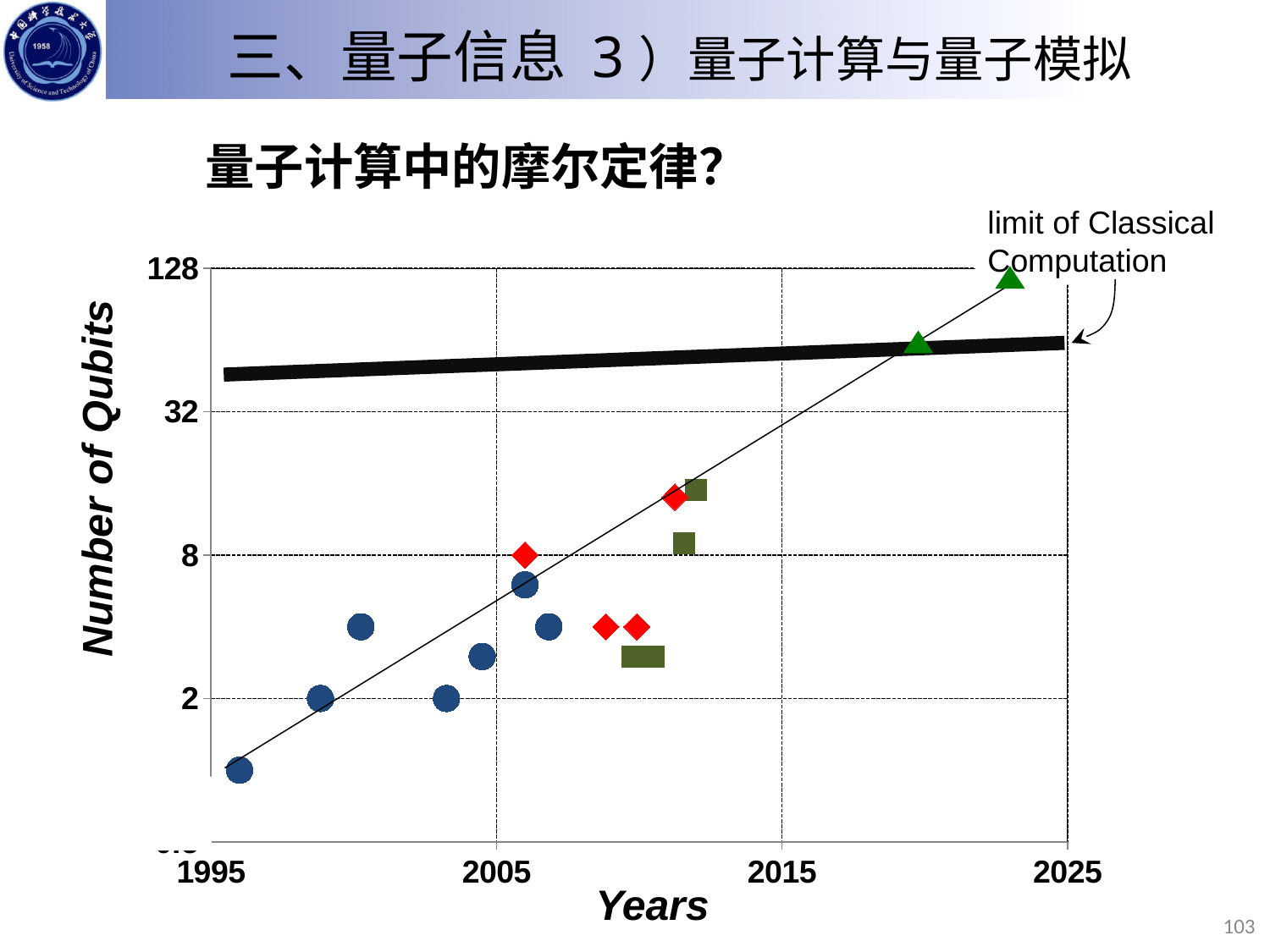
What does the thick black line on the chart represent, according to its label? limit of Classical Computation Which is higher: the green triangle near 2020 or the green triangle near 2023? the green triangle near 2023 Is the value of the green square plotted near 2012 greater or less than 8? greater How many green triangle markers are plotted on the chart? 2 Do the plotted numbers of qubits generally rise or fall as the years increase along the x axis? rise Is the value of the red diamond plotted near 2010 greater or less than 8? less Is the value of the green triangle plotted near 2023 greater or less than 32? greater Which marker type reaches the highest number of qubits on the chart? green triangle What kind of chart is shown on the slide? scatter chart What is the title of the y axis? Number of Qubits How many year labels are shown on the x axis? 4